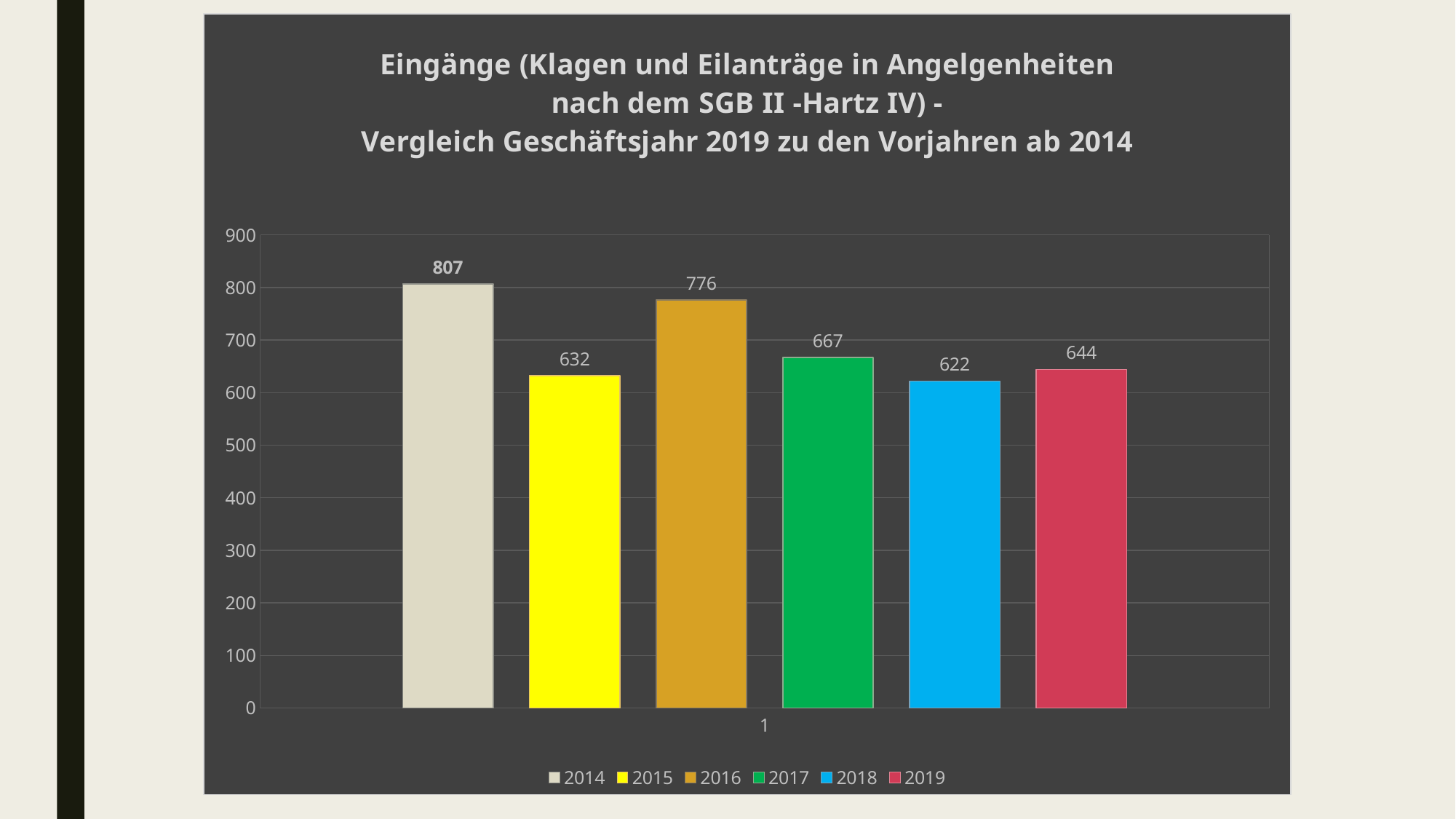
What is the value for 2014? 807 Is the value for 2016 greater or less than 700? greater What is the difference between the values for 2014 and 2019? 163 What colour is the bar for 2015? yellow Which year has the lowest value? 2018 Which year has the highest value? 2014 How many series does the legend list? 6 What kind of chart is shown on the slide? bar chart What is the value for 2017? 667 What is the difference between the values for 2016 and 2015? 144 What is the value for 2019? 644 Which is larger, the value for 2017 or the value for 2018? 2017